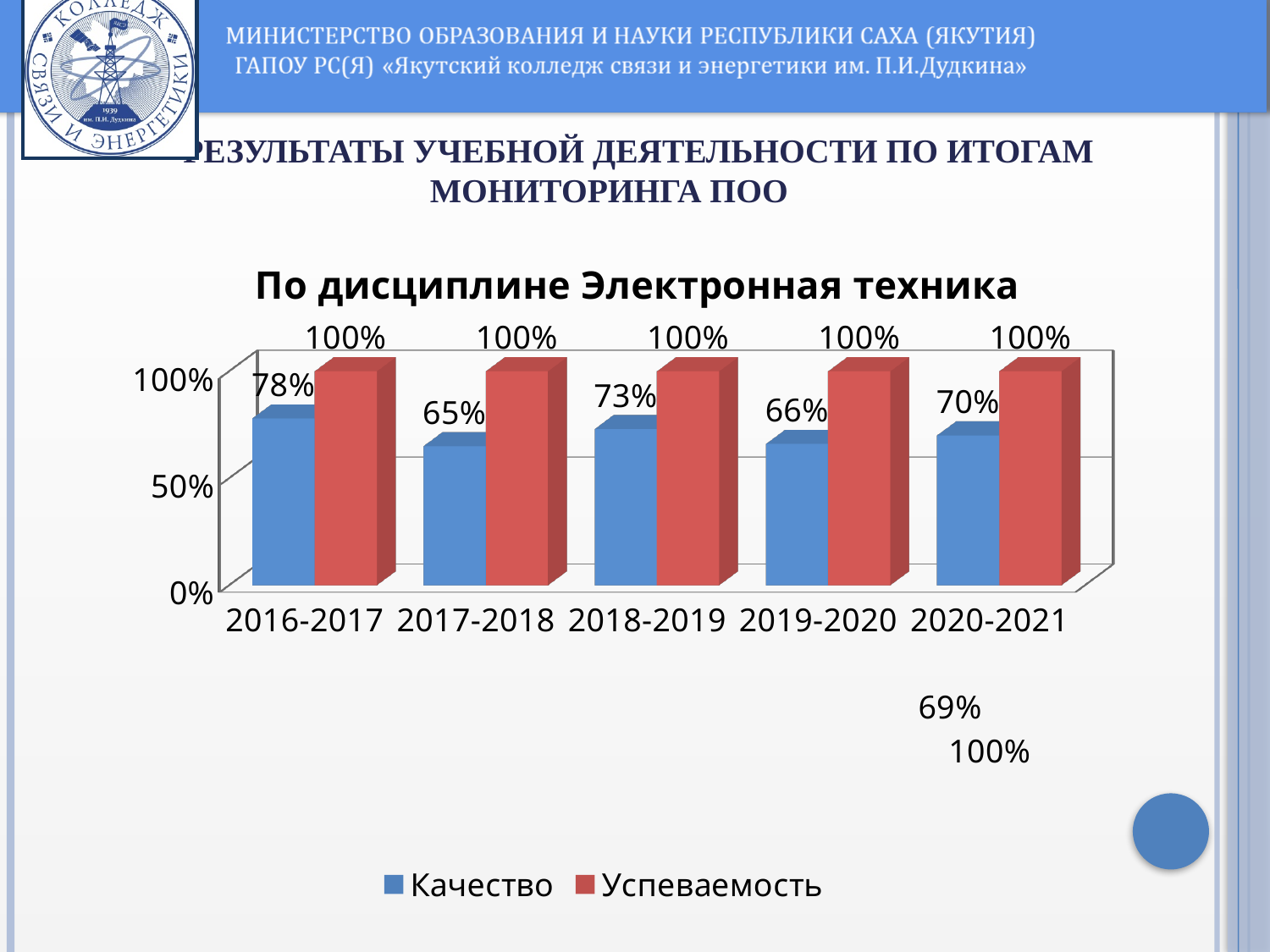
Which year has the highest Качество value? 2016-2017 What is the difference between Качество for 2016-2017 and 2017-2018? 13% Which is larger, Качество for 2018-2019 or Качество for 2019-2020? 2018-2019 How many academic years are shown on the x axis of the chart? 5 What is the value of Качество for 2016-2017? 78% Which year has the lowest Качество value? 2017-2018 How many series does the legend list? 2 What is the value of Качество for 2020-2021? 70% What is the value of Качество for 2017-2018? 65% What is the title of the chart? По дисциплине Электронная техника What is the value of Успеваемость for 2018-2019? 100% What kind of chart is shown on the slide? bar chart